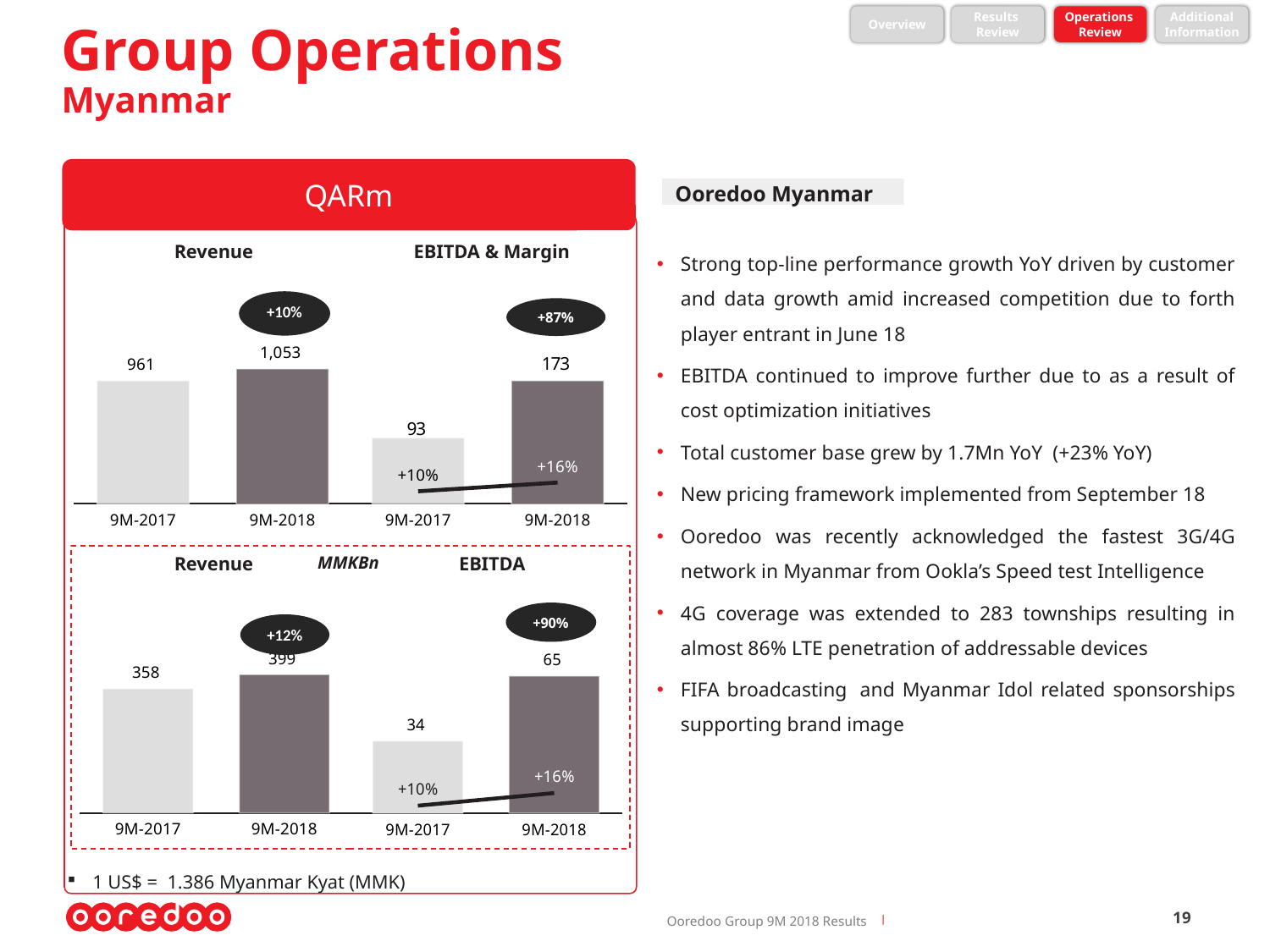
In the QARm Revenue chart, what is the revenue for 9M-2018? 1,053 What type of chart is used to show Revenue in the QARm panel? Bar chart In the QARm Revenue chart, what year-on-year growth percentage is shown in the oval? +10% In the QARm Revenue chart, what is the revenue for 9M-2017? 961 In the MMKBn EBITDA chart, what is the EBITDA for 9M-2018? 65 In the MMKBn EBITDA chart, which period has the higher EBITDA, 9M-2017 or 9M-2018? 9M-2018 In the QARm EBITDA & Margin chart, what is the EBITDA for 9M-2018? 173 In the MMKBn Revenue chart, what is the revenue for 9M-2017? 358 In the MMKBn Revenue chart, what is the difference in revenue between 9M-2018 and 9M-2017? 41 In the QARm EBITDA & Margin chart, what is the EBITDA for 9M-2017? 93 In the QARm EBITDA & Margin chart, what year-on-year growth percentage is shown in the oval? +87% In the QARm EBITDA & Margin chart, what is the difference in EBITDA between 9M-2018 and 9M-2017? 80